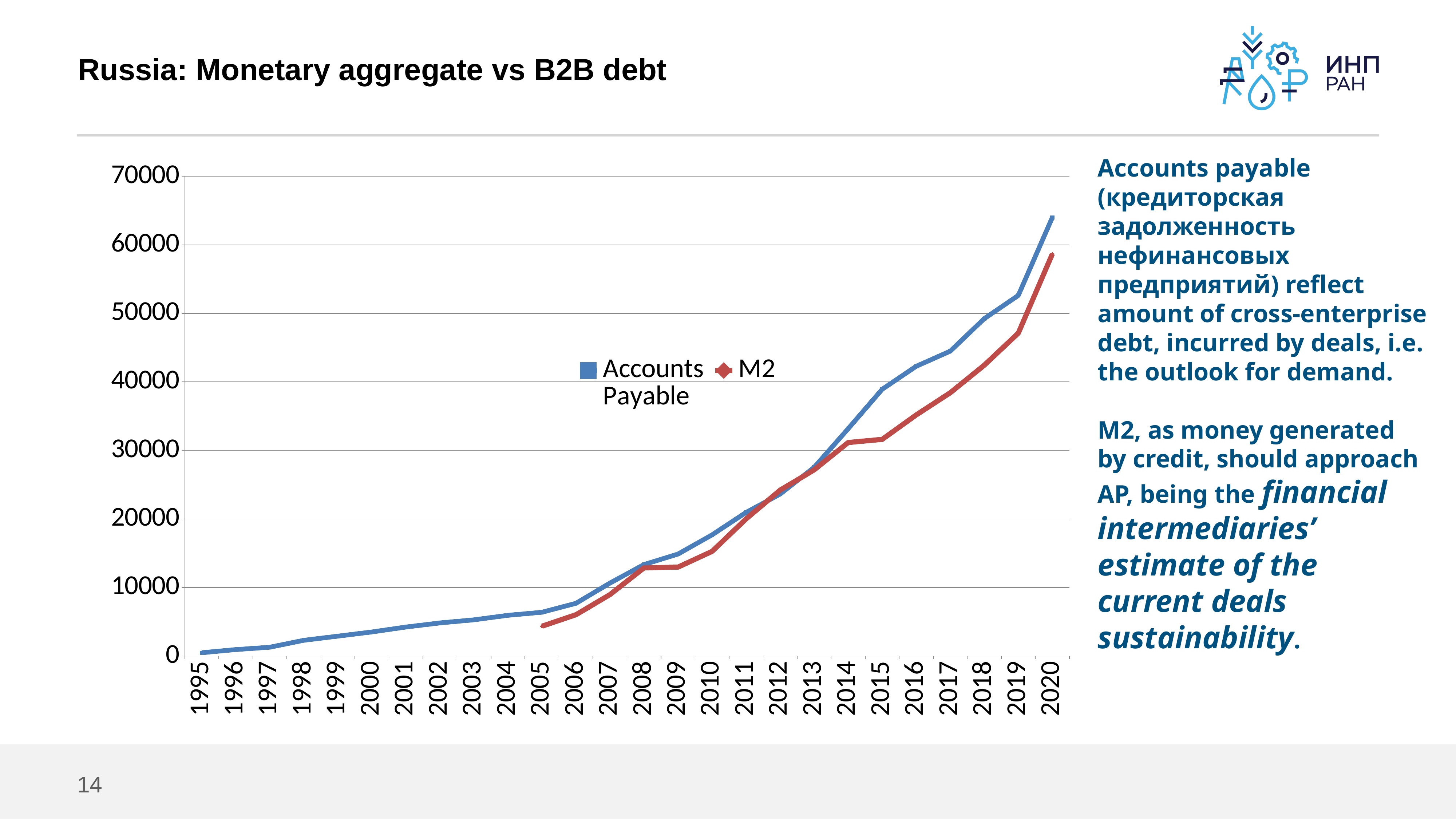
Is the Accounts Payable value for 2020 greater or less than 60000? greater What kind of chart is shown on the slide? line chart In which year is the Accounts Payable value lowest? 1995 In which year is the Accounts Payable value highest? 2020 In 2020, which series has the larger value, Accounts Payable or M2? Accounts Payable How many years are shown on the x axis? 26 Do the Accounts Payable values rise or fall from 1995 to 2020? rise Is the M2 value for 2020 greater or less than 50000? greater Is the M2 value for 2005 greater or less than 10000? less How many series does the legend list? 2 What is the title of the slide containing the chart? Russia: Monetary aggregate vs B2B debt Which two series are listed in the legend? Accounts Payable and M2